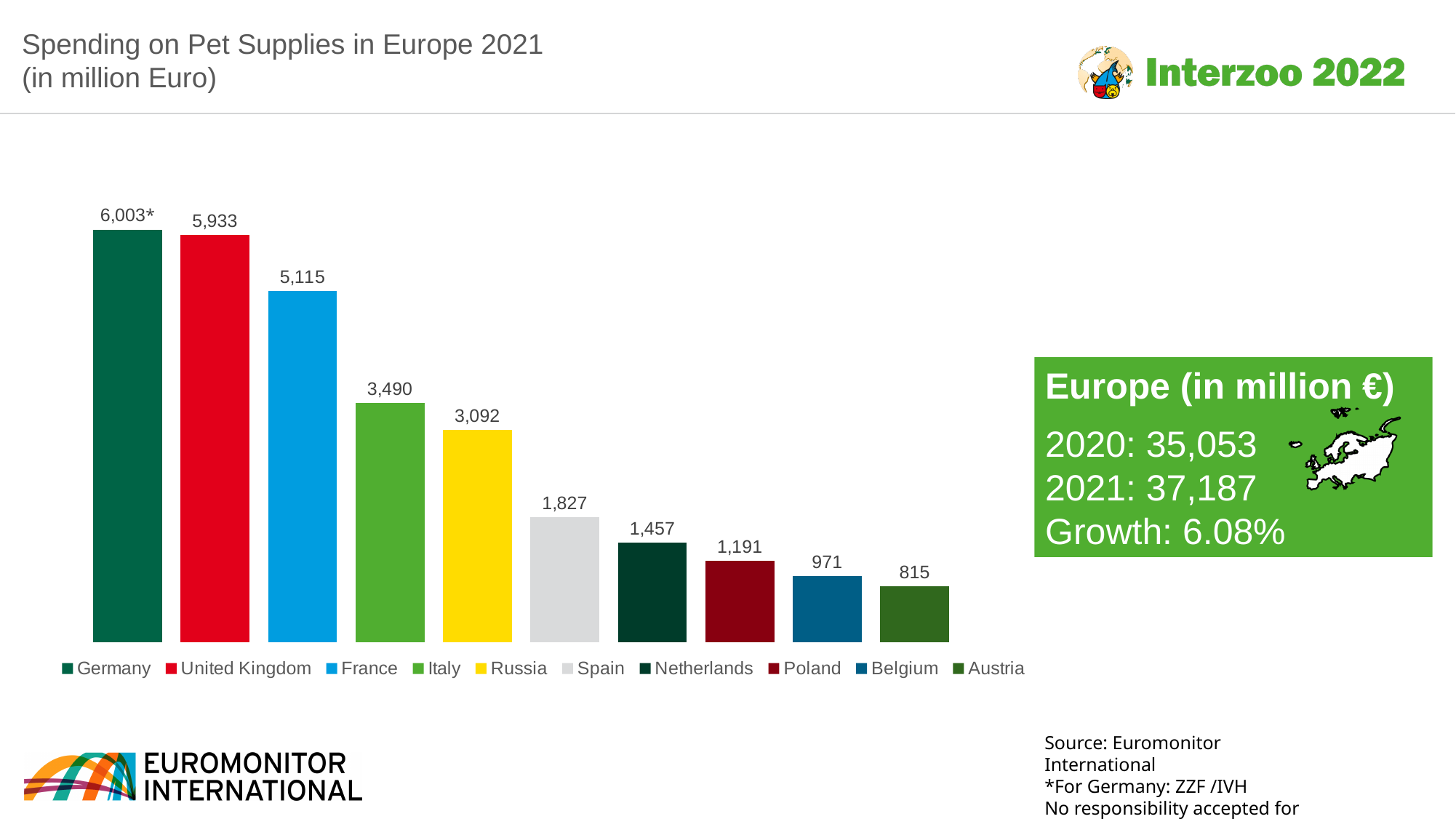
What is the title of the chart? Spending on Pet Supplies in Europe 2021 (in million Euro) What is the spending on pet supplies for France? 5,115 How many countries are shown in the chart? 10 Which country has the lowest spending on pet supplies? Austria Which country has the highest spending on pet supplies? Germany What is the difference in spending between the Netherlands and Belgium? 486 What type of chart is shown on the slide? Bar chart What is the spending on pet supplies for Spain? 1,827 Do the values rise or fall from left to right across the chart? Fall Which has higher spending on pet supplies, the United Kingdom or France? United Kingdom What is the difference in spending between Italy and Russia? 398 What is the spending on pet supplies for Poland? 1,191